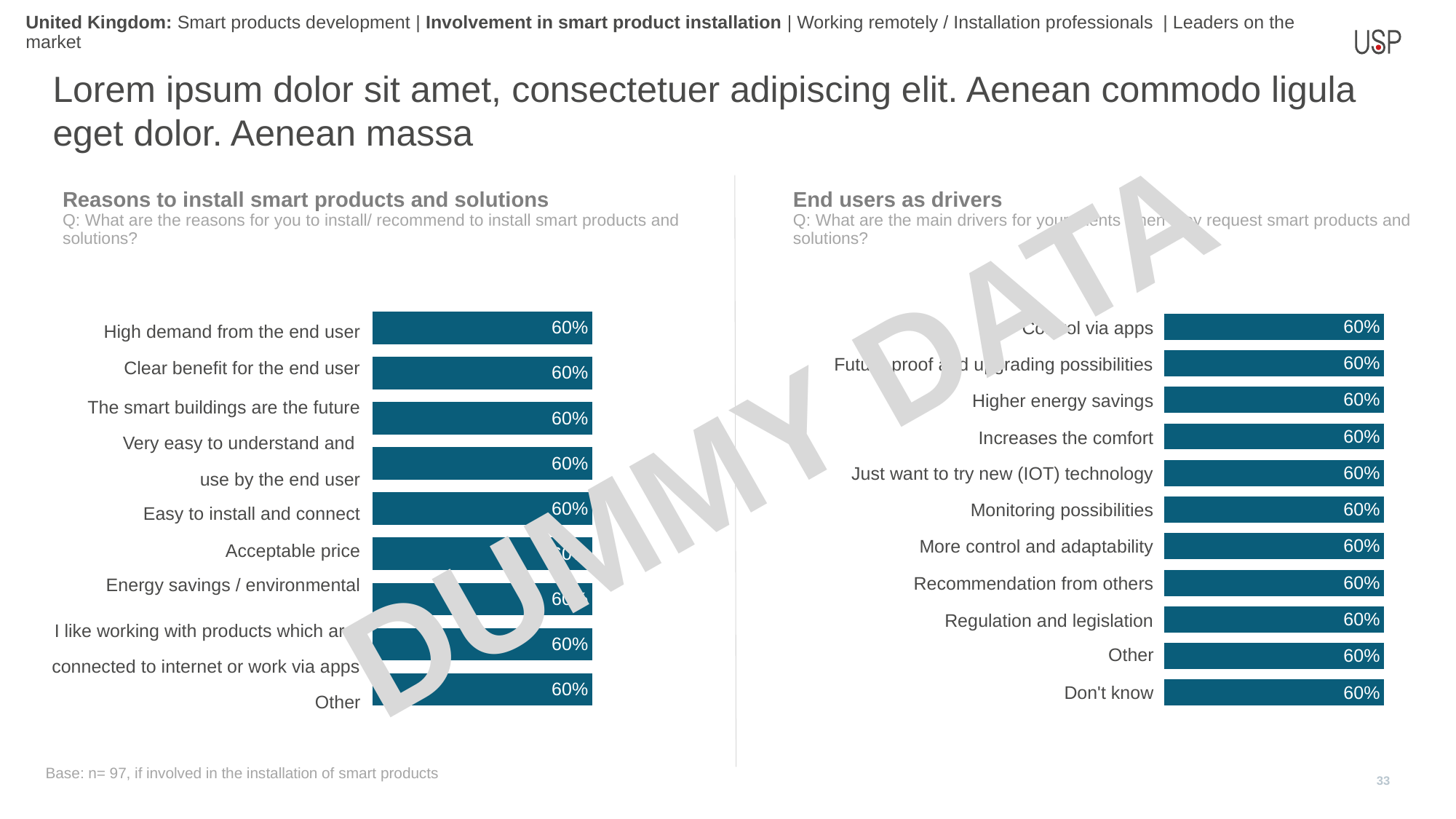
How many categories are shown in the 'End users as drivers' chart? 11 In the 'End users as drivers' chart, what is the value for 'Don't know'? 60% In the 'End users as drivers' chart, what is the difference between the values for 'Monitoring possibilities' and 'Recommendation from others'? 0% What kind of chart is the 'End users as drivers' chart? Bar chart What base size is stated at the bottom of the slide? n= 97 In the 'Reasons to install smart products and solutions' chart, what is the value for 'Other'? 60% In the 'Reasons to install smart products and solutions' chart, what is the value for 'High demand from the end user'? 60% How many categories are shown in the 'Reasons to install smart products and solutions' chart? 9 In the 'End users as drivers' chart, what is the value for 'Higher energy savings'? 60% In the 'End users as drivers' chart, what is the value for 'Regulation and legislation'? 60% What is the title of the chart on the left side of the slide? Reasons to install smart products and solutions In the 'Reasons to install smart products and solutions' chart, what is the value for 'Easy to install and connect'? 60%